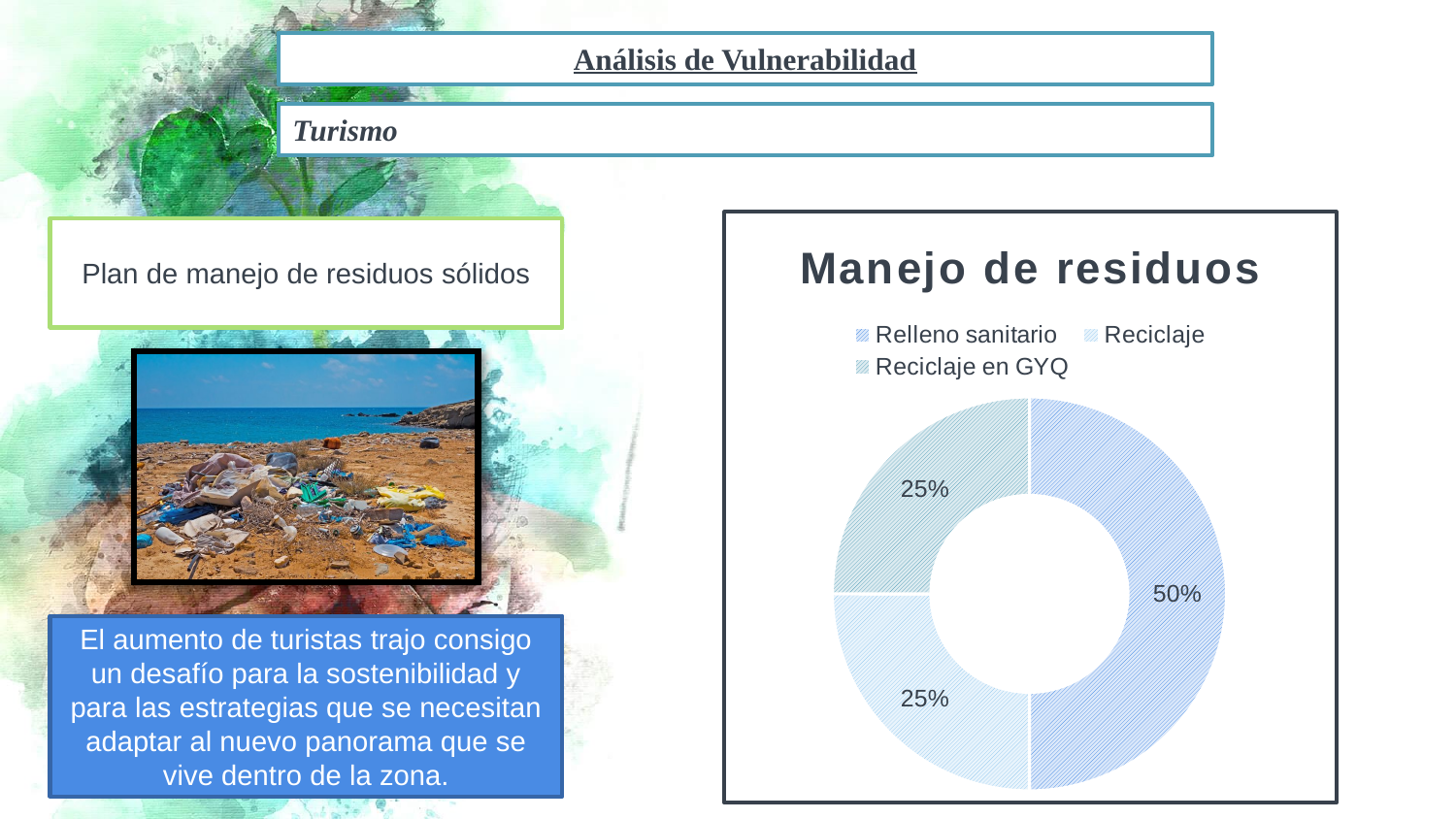
What share of the chart does Reciclaje represent? 25% What share of the chart does Relleno sanitario represent? 50% What share of the chart does Reciclaje en GYQ represent? 25% How many categories does the chart's legend list? 3 What is the combined share of Reciclaje and Reciclaje en GYQ? 50% What kind of chart is shown on the slide? Doughnut (pie) chart Which is larger, the share for Relleno sanitario or the share for Reciclaje? Relleno sanitario Which legend entries are listed in the chart? Relleno sanitario, Reciclaje, Reciclaje en GYQ How many slices does the doughnut chart have? 3 What is the title of the chart? Manejo de residuos What is the difference between the share for Relleno sanitario and the share for Reciclaje en GYQ? 25% Which category has the largest share in the chart? Relleno sanitario